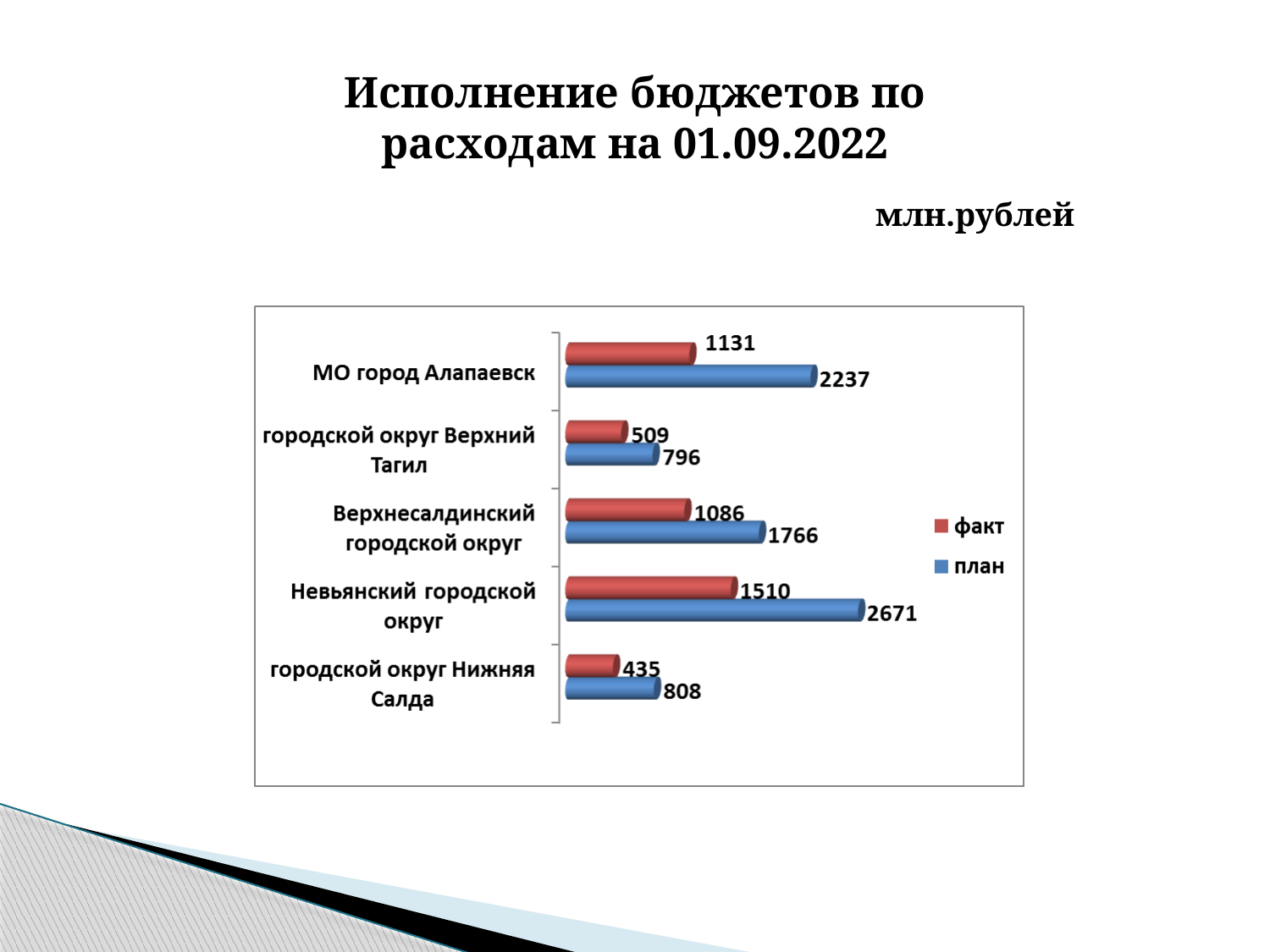
What is the difference between план and факт for МО город Алапаевск? 1106 What kind of chart is shown on the slide? bar chart What is the план value for Невьянский городской округ? 2671 What is the факт value for городской округ Нижняя Салда? 435 Which category has the lowest факт value? городской округ Нижняя Салда What is the difference between план and факт for Верхнесалдинский городской округ? 680 Which is larger: the план value for городской округ Верхний Тагил or the план value for городской округ Нижняя Салда? городской округ Нижняя Салда Which colour represents the факт series in the legend? red How many series does the legend list? 2 How many categories are shown on the chart? 5 What is the факт value for МО город Алапаевск? 1131 Which category has the highest план value? Невьянский городской округ